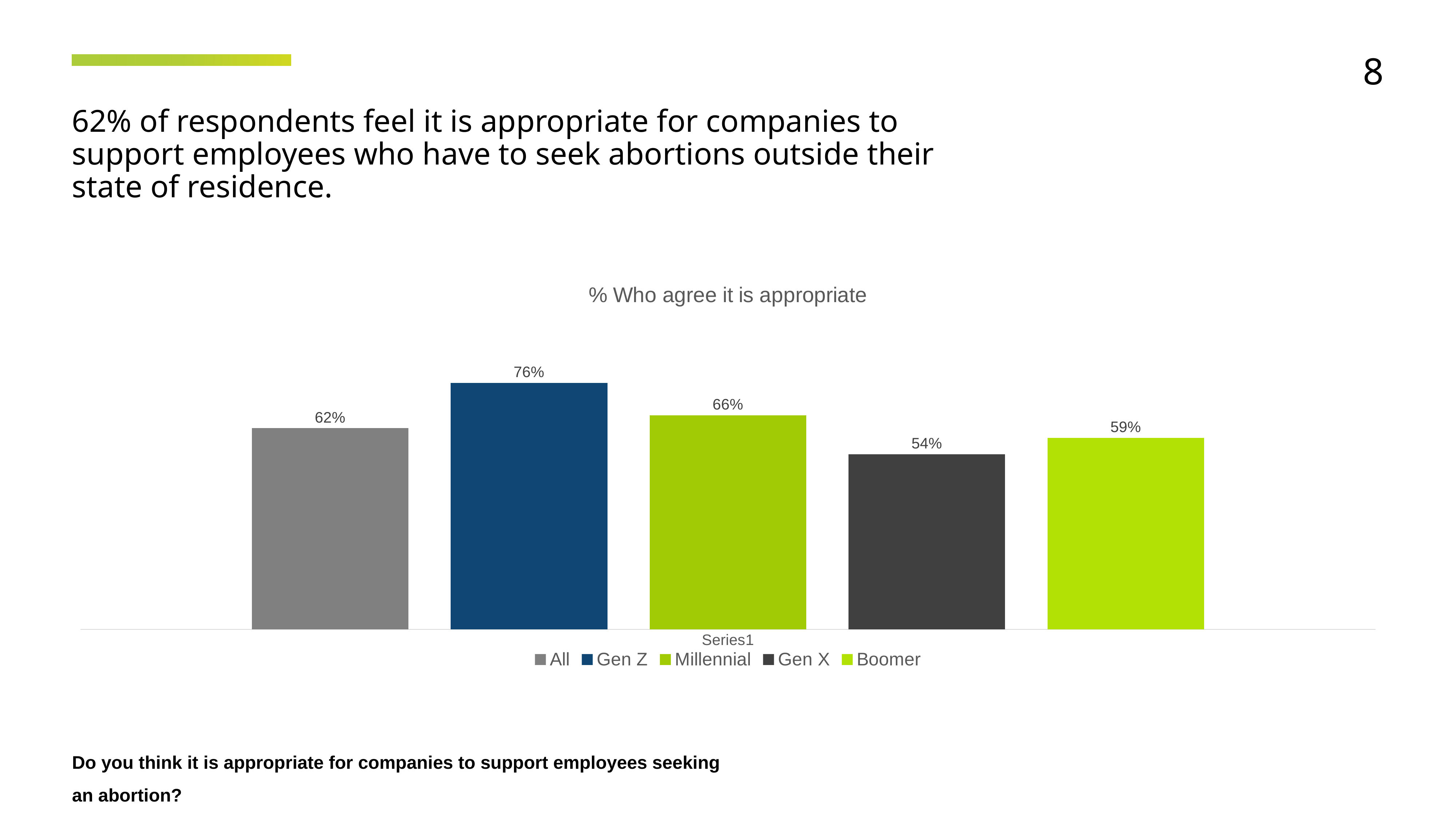
What is the difference between the Millennial value and the All value? 4% Which is larger, the value for Boomer or the value for Gen X? Boomer What is the value shown for Gen X? 54% How many bars are shown in the chart? 5 Which group has the lowest percentage who agree it is appropriate? Gen X What type of chart is shown on the slide? Bar chart What is the value shown for Millennial? 66% What percentage of Gen Z respondents agree it is appropriate? 76% What is the difference between the Gen Z value and the Gen X value? 22% What is the value shown for Boomer? 59% How many entries does the legend list? 5 Which group has the highest percentage who agree it is appropriate? Gen Z